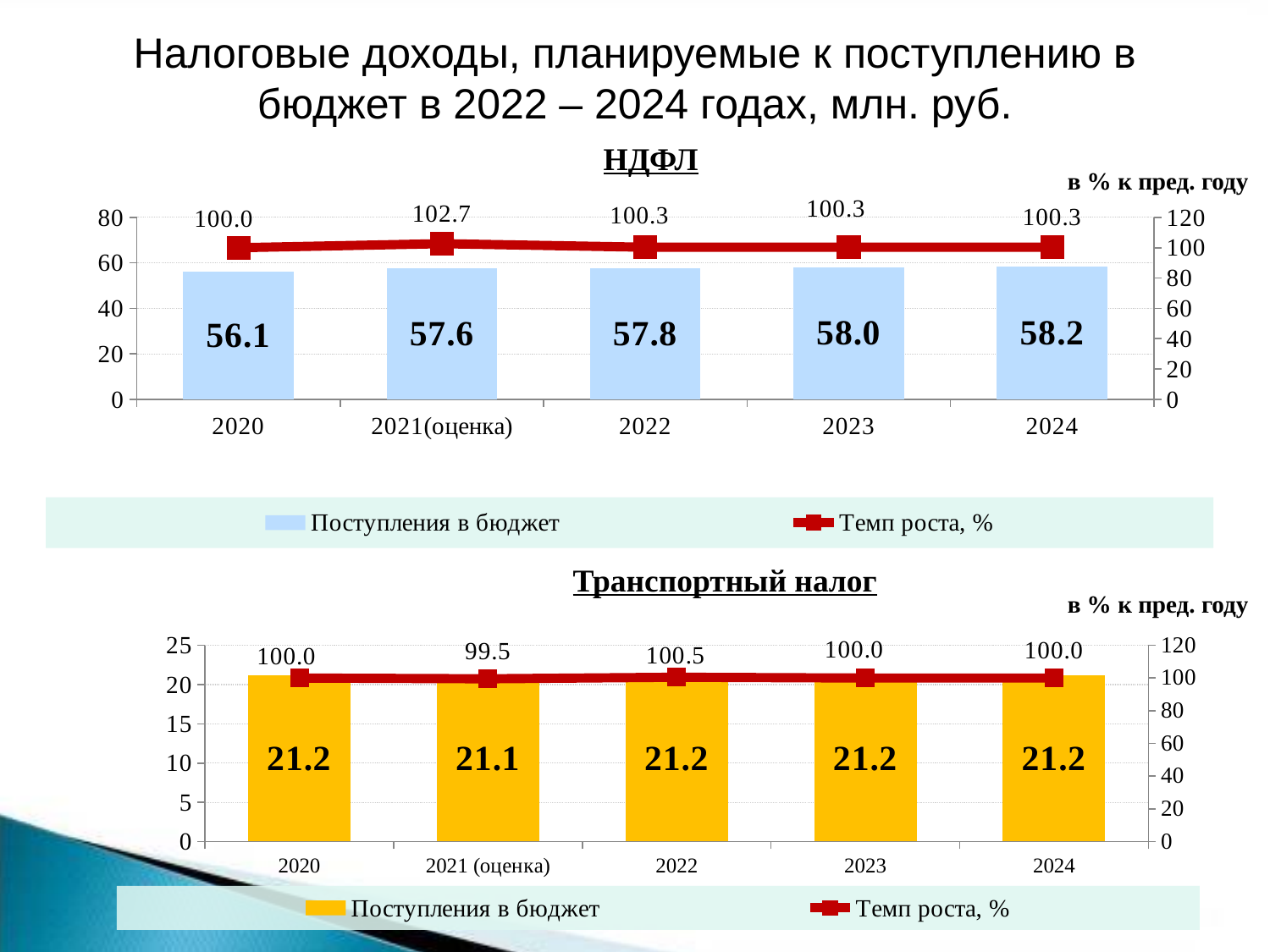
In the НДФЛ chart, what is the difference between the Поступления в бюджет values for 2024 and 2020? 2.1 In the Транспортный налог chart, what is the value of Поступления в бюджет for 2021 (оценка)? 21.1 In the НДФЛ chart, which year has the highest Поступления в бюджет value? 2024 In the НДФЛ chart, how many series does the legend list? 2 In the Транспортный налог chart, how many years are shown on the x axis? 5 In the НДФЛ chart, what is the Темп роста, % value for 2021(оценка)? 102.7 In the Транспортный налог chart, what colour are the Поступления в бюджет bars? yellow In the НДФЛ chart, do the Поступления в бюджет values rise or fall from 2020 to 2024? rise In the Транспортный налог chart, which year has the lowest Темп роста, % value? 2021 (оценка) In the Транспортный налог chart, what is the Темп роста, % value for 2022? 100.5 In the НДФЛ chart, what is the value of Поступления в бюджет for 2022? 57.8 In the НДФЛ chart, which year has the lowest Поступления в бюджет value? 2020